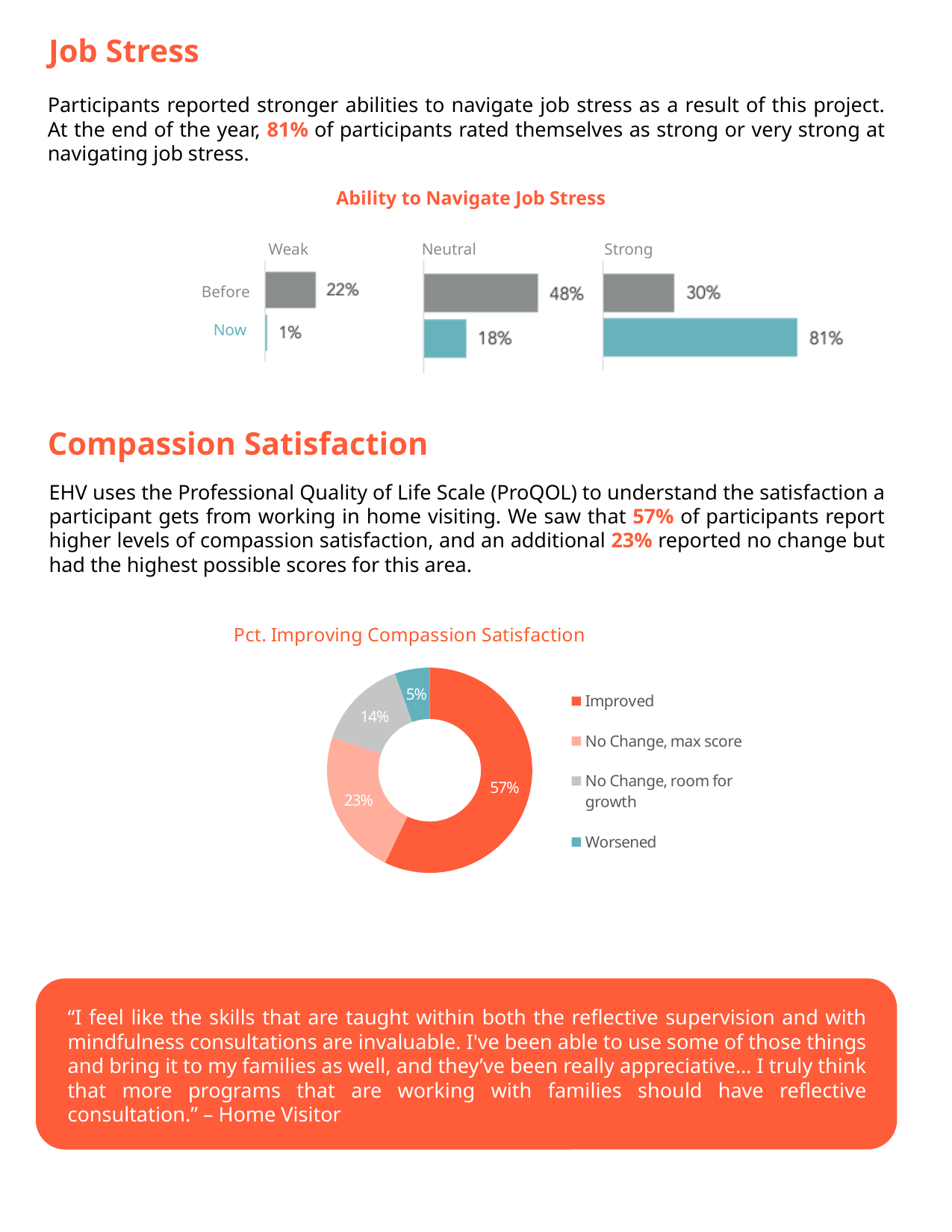
In the 'Pct. Improving Compassion Satisfaction' chart, what percentage Worsened? 5% In the 'Ability to Navigate Job Stress' chart, which rating category had the highest Before value? Neutral In the 'Pct. Improving Compassion Satisfaction' chart, which category has the smallest share? Worsened In the 'Ability to Navigate Job Stress' chart, what percentage of participants rated themselves as Strong now? 81% In the 'Ability to Navigate Job Stress' chart, what is the Weak percentage now? 1% How many categories does the legend of the 'Pct. Improving Compassion Satisfaction' chart list? 4 In the 'Pct. Improving Compassion Satisfaction' chart, what share of participants Improved? 57% What type of chart is 'Ability to Navigate Job Stress'? Bar chart In the 'Ability to Navigate Job Stress' chart, what was the Neutral percentage before? 48% In the 'Ability to Navigate Job Stress' chart, is the Before value for Weak larger or smaller than the Now value for Neutral? larger In the 'Pct. Improving Compassion Satisfaction' chart, what is the difference between 'No Change, max score' and 'No Change, room for growth'? 9 percentage points In the 'Ability to Navigate Job Stress' chart, by how many percentage points did the Strong rating increase from Before to Now? 51